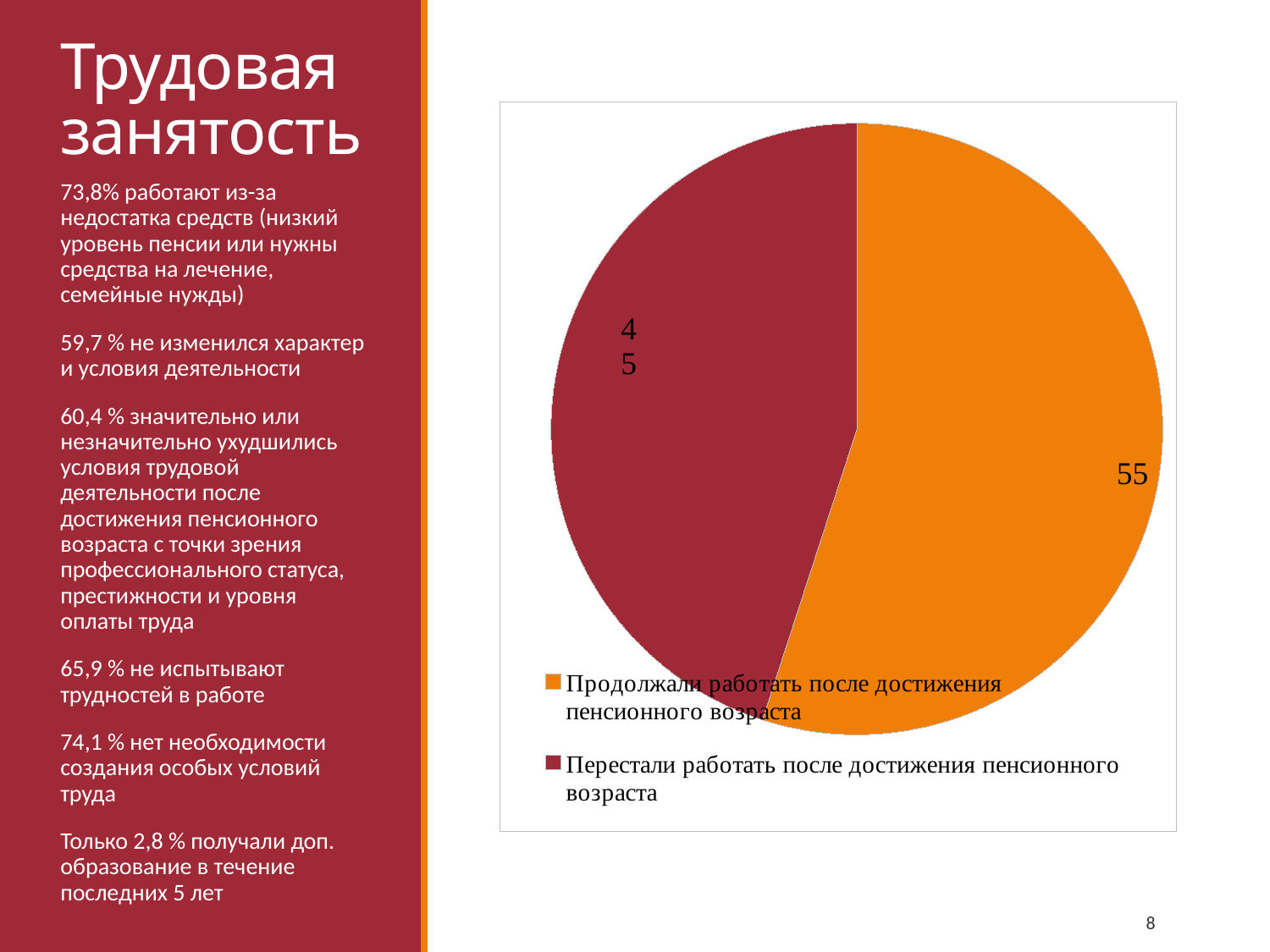
What kind of chart is shown on the slide? pie chart How many slices does the pie chart have? 2 Which category has the largest slice of the pie? Продолжали работать после достижения пенсионного возраста What share of the pie does "Продолжали работать после достижения пенсионного возраста" represent? 55% What colour is the slice for "Продолжали работать после достижения пенсионного возраста"? orange What is the difference between the values for "Продолжали работать после достижения пенсионного возраста" and "Перестали работать после достижения пенсионного возраста"? 10 Which category has the smallest slice of the pie? Перестали работать после достижения пенсионного возраста What share of the pie does "Перестали работать после достижения пенсионного возраста" represent? 45% What is the value for "Перестали работать после достижения пенсионного возраста"? 45 What is the value for "Продолжали работать после достижения пенсионного возраста"? 55 How many entries does the legend list? 2 Which is larger: the value for "Продолжали работать после достижения пенсионного возраста" or for "Перестали работать после достижения пенсионного возраста"? Продолжали работать после достижения пенсионного возраста